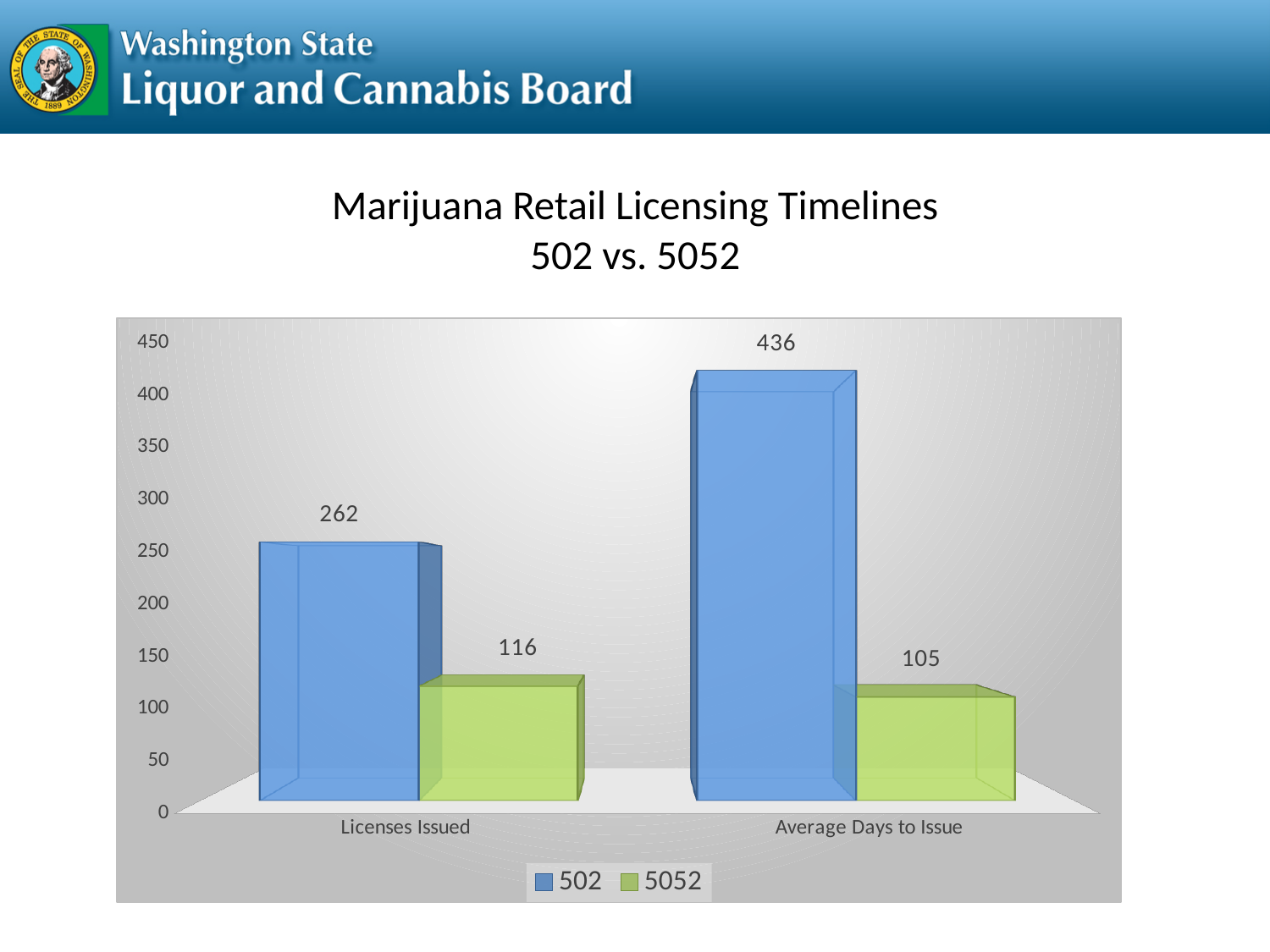
What is the value for 502 in the Licenses Issued category? 262 What is the difference between the 502 and 5052 values for Licenses Issued? 146 Which category has the lowest value for the 5052 series? Average Days to Issue Which is larger: the 502 value for Licenses Issued or the 502 value for Average Days to Issue? Average Days to Issue What is the difference between the 502 and 5052 values for Average Days to Issue? 331 How many series does the legend list? 2 What is the value for 5052 in the Licenses Issued category? 116 Is the value for 502 in Licenses Issued greater or less than 250? greater What kind of chart is shown on the slide? bar chart What is the value for 5052 in the Average Days to Issue category? 105 How many categories are shown on the x axis? 2 Which series has the highest value in the Average Days to Issue category? 502